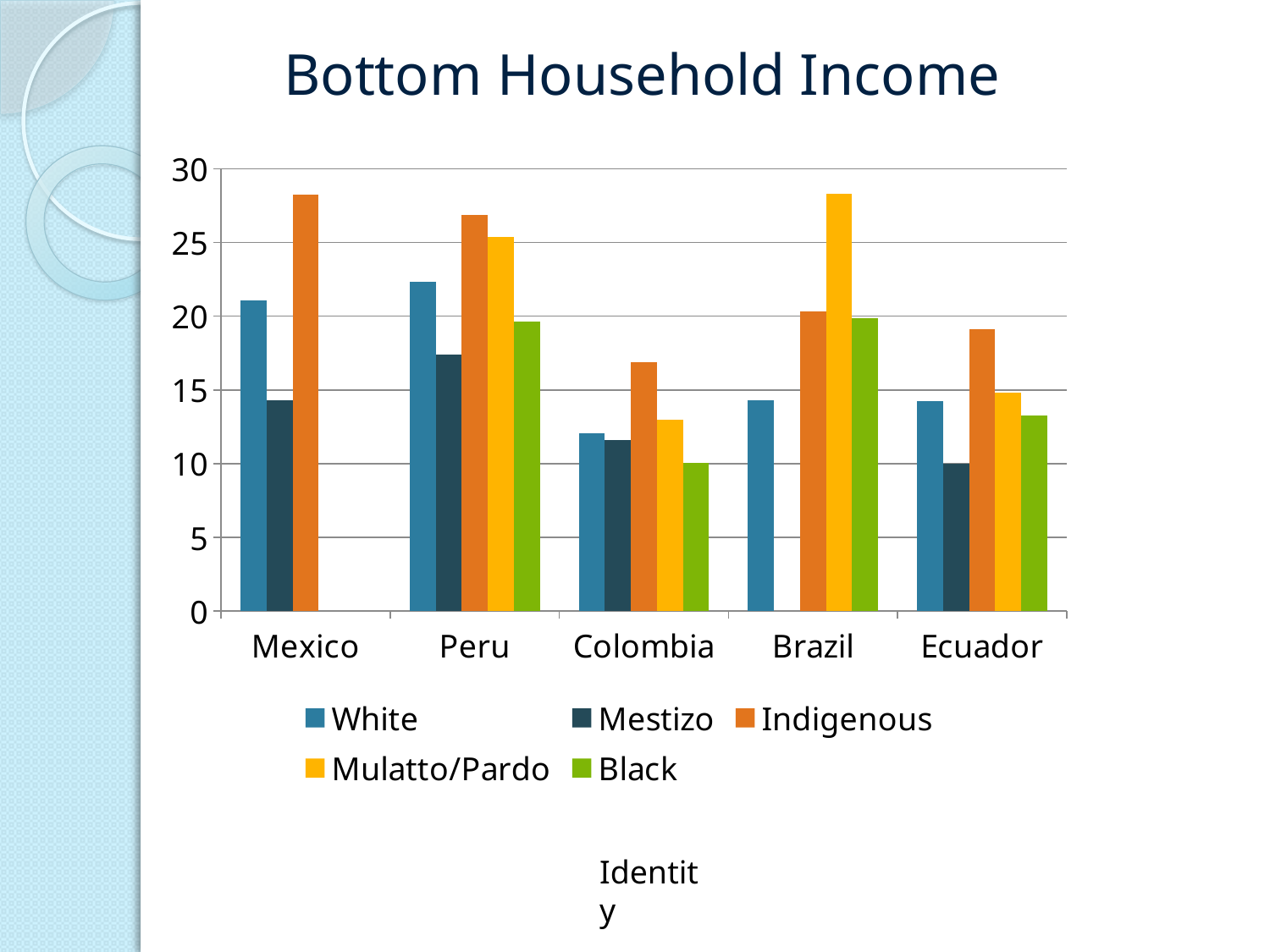
For Ecuador, which is larger, the Indigenous value or the Mulatto/Pardo value? Indigenous Is the Indigenous value for Mexico greater or less than 25? greater How many series does the legend list? 5 What kind of chart is shown on the slide? bar chart Is the Mestizo value for Peru greater or less than 20? less Which group has the lowest value for Colombia? Black How many countries are shown on the x axis? 5 Is the White value for Peru greater or less than 20? greater For Mexico, which is larger, the White value or the Mestizo value? White Which group has the highest value for Mexico? Indigenous Which group has the highest value for Brazil? Mulatto/Pardo What is the title of the chart? Bottom Household Income